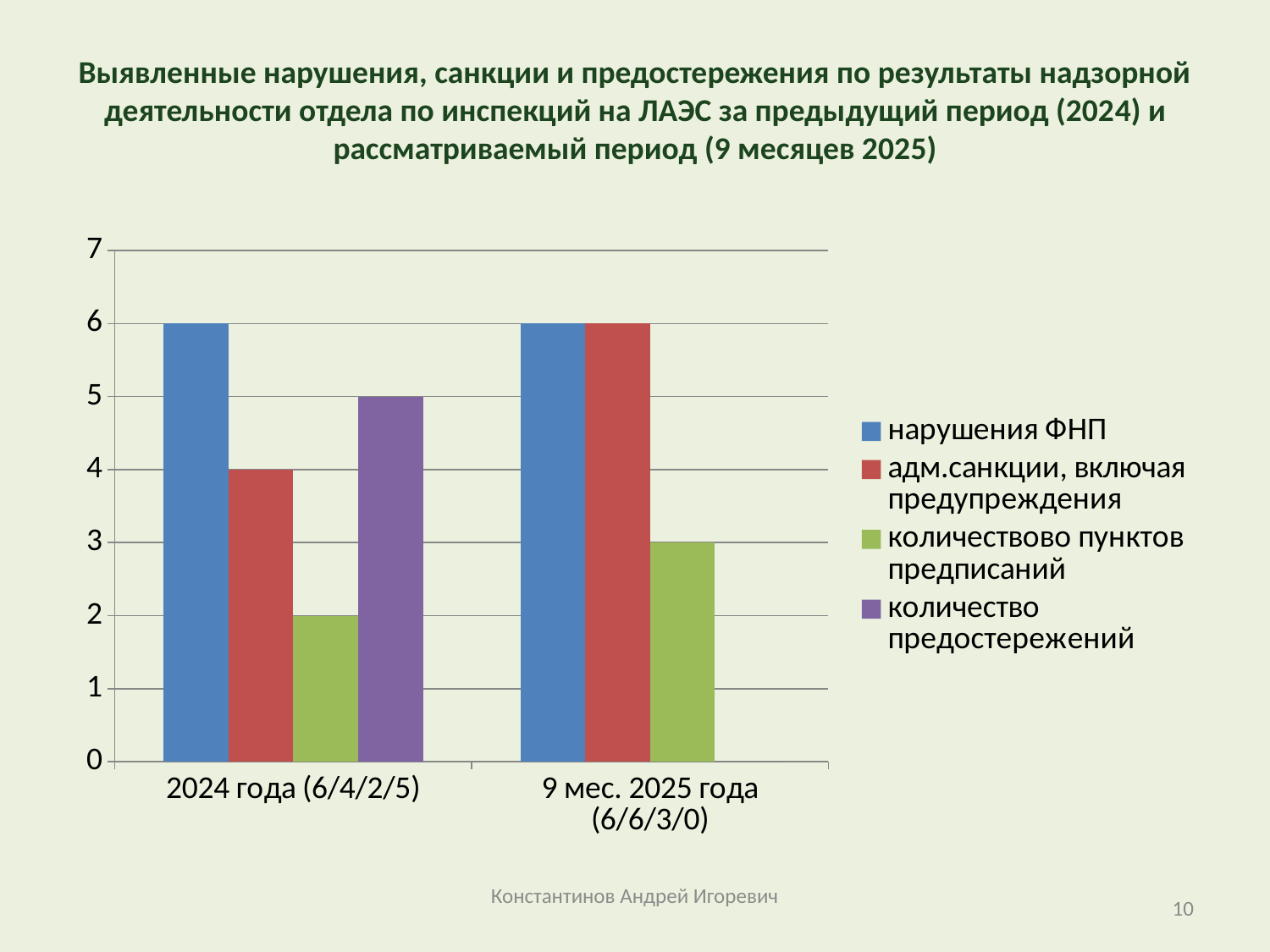
Which series has the lowest value for 9 мес. 2025 года? количество предостережений What kind of chart is shown on the slide? bar chart Does the value of количествово пунктов предписаний rise or fall from 2024 года to 9 мес. 2025 года? rise What is the value of адм.санкции, включая предупреждения for 9 мес. 2025 года? 6 How many categories are shown on the x axis? 2 How many series does the legend list? 4 Which is larger: количество предостережений for 2024 года or for 9 мес. 2025 года? 2024 года Which series has the lowest value for 2024 года? количествово пунктов предписаний What is the value of нарушения ФНП for 2024 года? 6 What is the difference between адм.санкции, включая предупреждения for 9 мес. 2025 года and for 2024 года? 2 What is the value of количествово пунктов предписаний for 9 мес. 2025 года? 3 What is the value of количество предостережений for 2024 года? 5